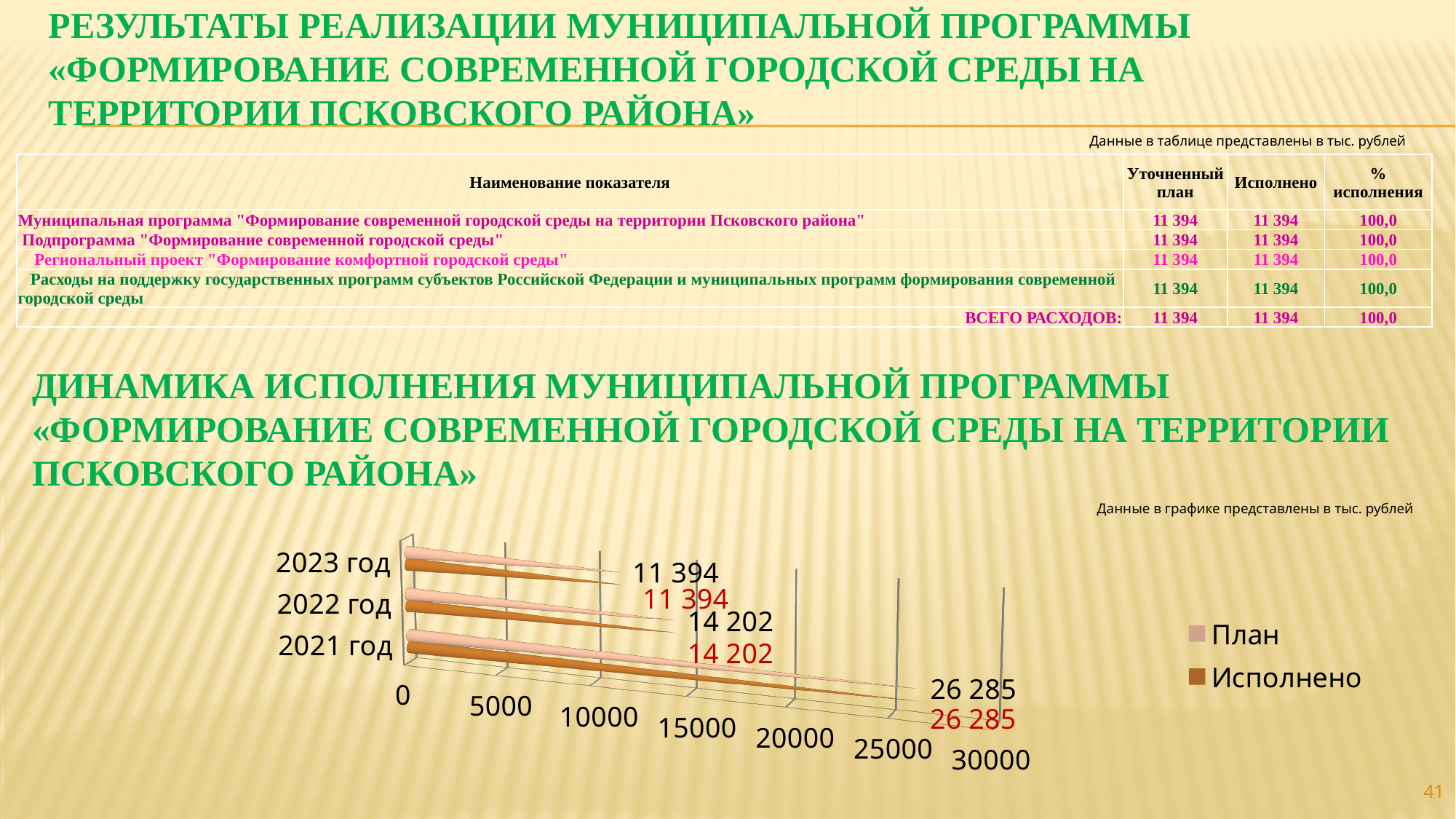
What is the Исполнено value for 2022 год on the chart? 14 202 What is the План value for 2021 год on the chart? 26 285 How many years (categories) are shown on the chart? 3 Which year has the highest Исполнено value on the chart? 2021 год How many series does the chart legend list? 2 What type of chart is shown on the slide? bar chart Which is larger on the chart: the План value for 2022 год or for 2023 год? 2022 год Is the Исполнено value for 2021 год greater or less than 25000? greater What are the two legend entries of the chart? План, Исполнено What is the difference between the Исполнено values for 2021 год and 2023 год? 14 891 What is the План value for 2023 год on the chart? 11 394 Which year has the lowest План value on the chart? 2023 год